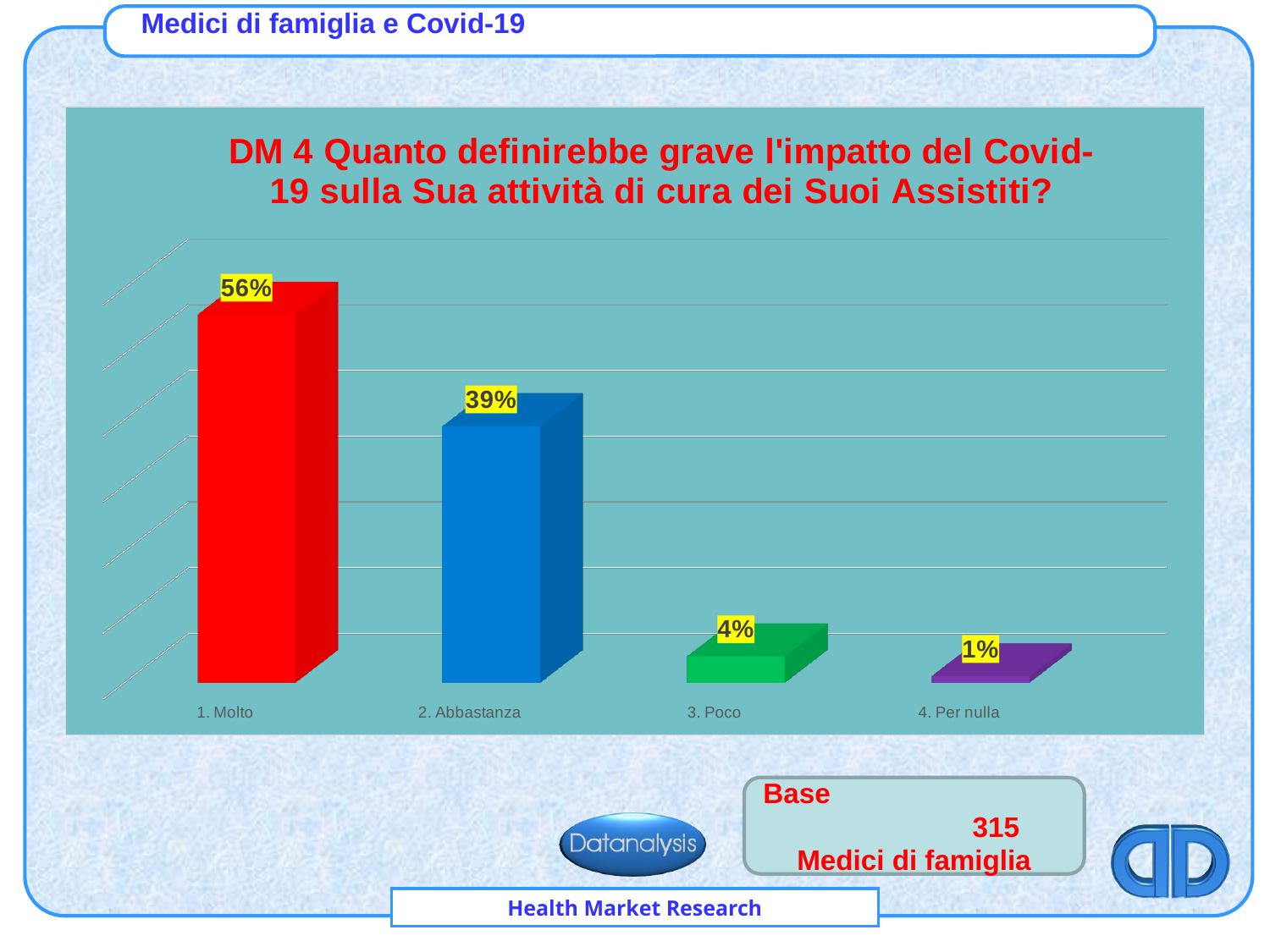
What is the value for "2. Abbastanza"? 39% Which category has the lowest value? 4. Per nulla What colour is the bar for "2. Abbastanza"? Blue What kind of chart is shown on the slide? Bar chart Which category has the highest value? 1. Molto What is the value for "4. Per nulla"? 1% Do the values rise or fall from left to right along the x axis? Fall Which is larger, the value for "3. Poco" or the value for "4. Per nulla"? 3. Poco What is the value for "1. Molto"? 56% How many categories are shown in the chart? 4 What is the value for "3. Poco"? 4% What is the difference between the values for "1. Molto" and "2. Abbastanza"? 17%